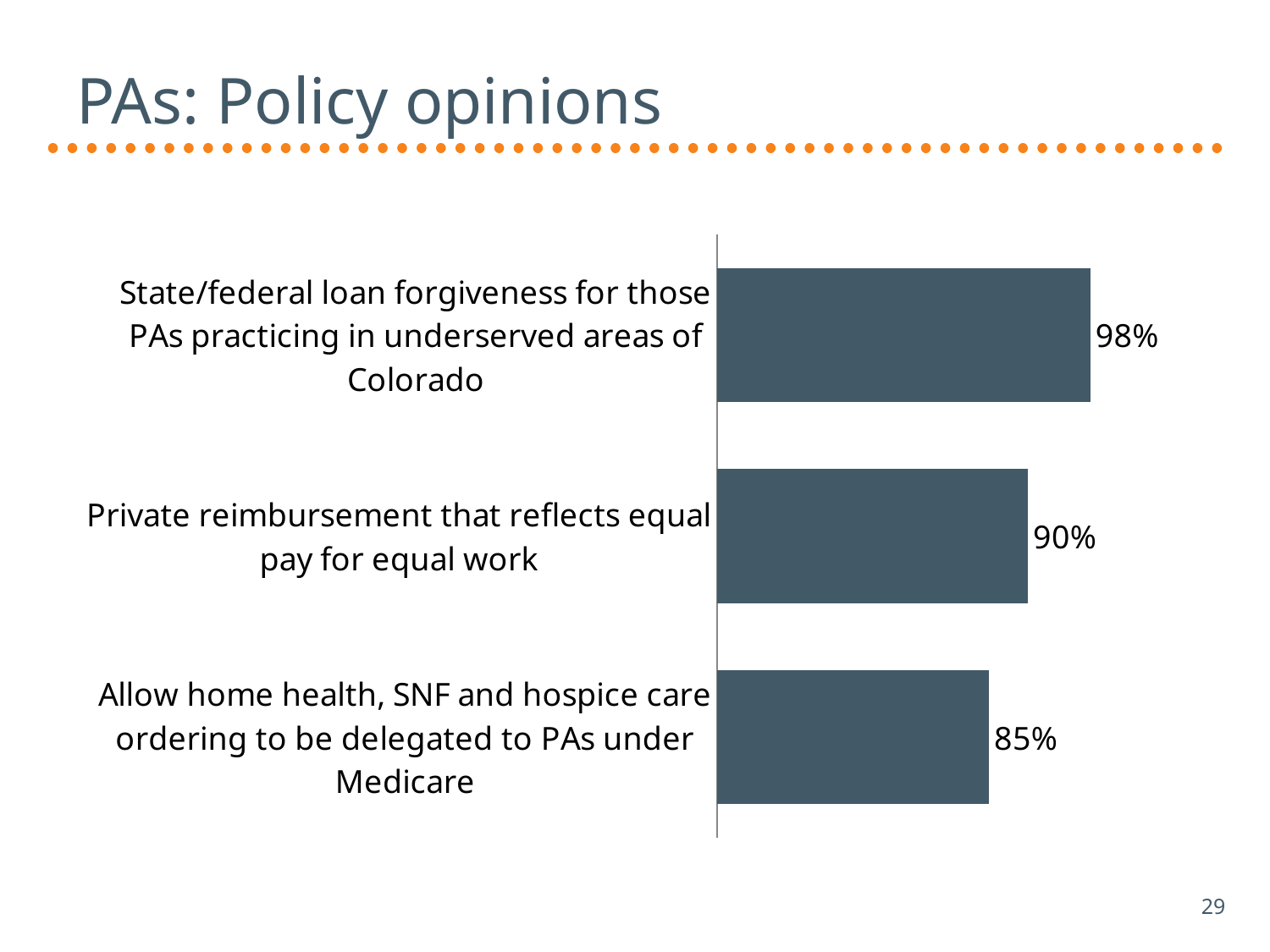
Which is larger: the value for private reimbursement that reflects equal pay for equal work or the value for delegating home health, SNF and hospice care ordering to PAs under Medicare? Private reimbursement that reflects equal pay for equal work What is the difference between the value for loan forgiveness and the value for private reimbursement that reflects equal pay for equal work? 8% What is the value for private reimbursement that reflects equal pay for equal work? 90% Which policy has the lowest level of support? Allow home health, SNF and hospice care ordering to be delegated to PAs under Medicare What is the difference between the highest and lowest values on the chart? 13% What percentage of PAs support state/federal loan forgiveness for those PAs practicing in underserved areas of Colorado? 98% What is the value for allowing home health, SNF and hospice care ordering to be delegated to PAs under Medicare? 85% Which policy has the highest level of support? State/federal loan forgiveness for those PAs practicing in underserved areas of Colorado What is the title of the slide? PAs: Policy opinions Are the bars on the chart horizontal or vertical? Horizontal How many policy categories are shown on the chart? 3 What kind of chart is shown on the slide? Bar chart